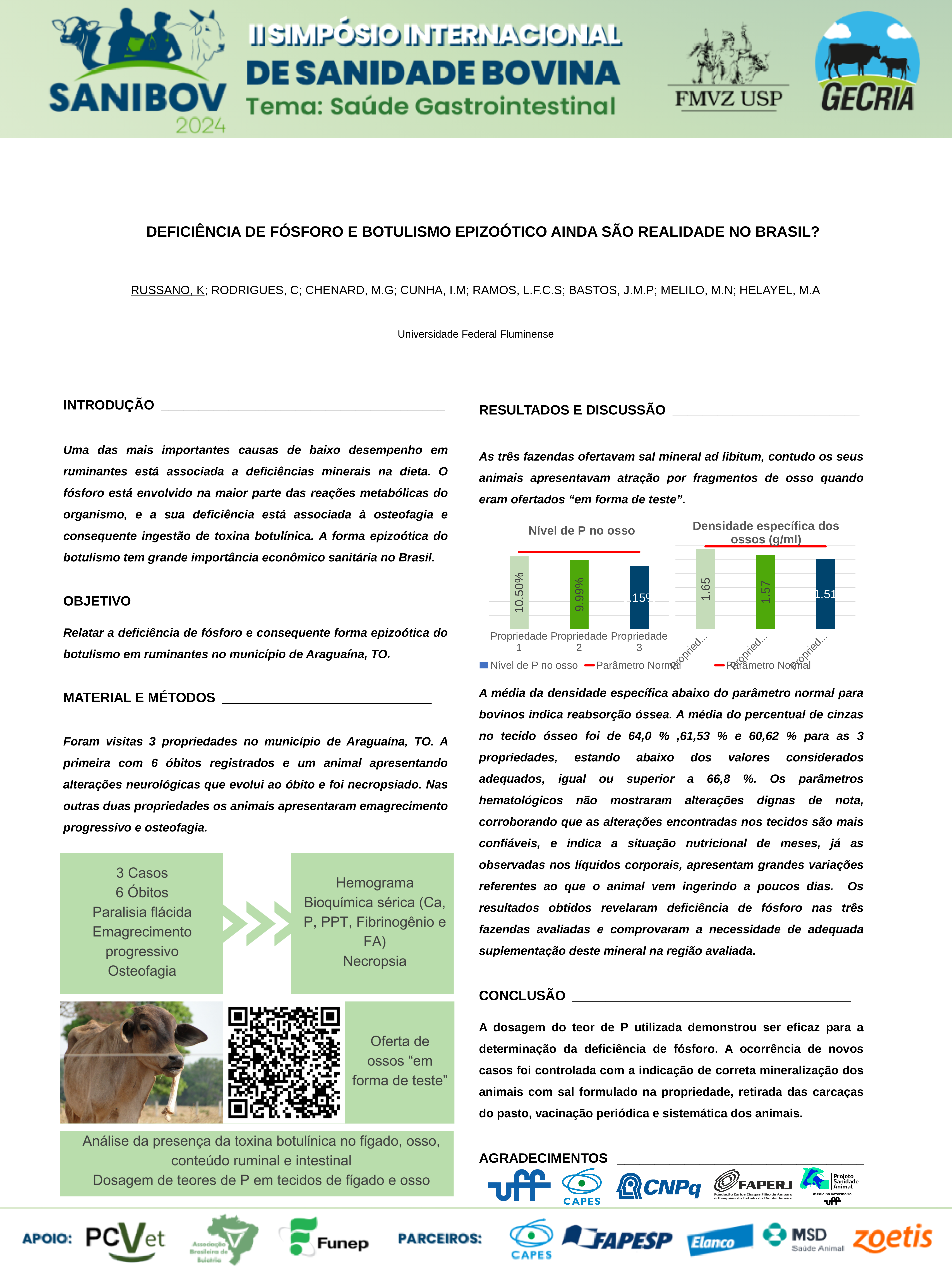
In the chart titled "Densidade específica dos ossos (g/ml)", do the values rise or fall from left to right? fall In the chart titled "Nível de P no osso", how many properties are plotted? 3 In the chart titled "Nível de P no osso", which property has the lowest value? Propriedade 3 In the chart titled "Nível de P no osso", how many entries does the legend list? 2 In the chart titled "Densidade específica dos ossos (g/ml)", what is the value of the first bar? 1.65 In the chart titled "Densidade específica dos ossos (g/ml)", what is the difference between the first and third bars? 0.14 In the chart titled "Nível de P no osso", what is the difference between the values for Propriedade 1 and Propriedade 2? 0.51% In the chart titled "Nível de P no osso", what is the value for Propriedade 2? 9.99% In the chart titled "Nível de P no osso", what is the value for Propriedade 1? 10.50% In the chart titled "Nível de P no osso", which property has the highest value? Propriedade 1 In the chart titled "Densidade específica dos ossos (g/ml)", what is the value of the third bar? 1.51 What kind of chart is "Densidade específica dos ossos (g/ml)"? bar chart